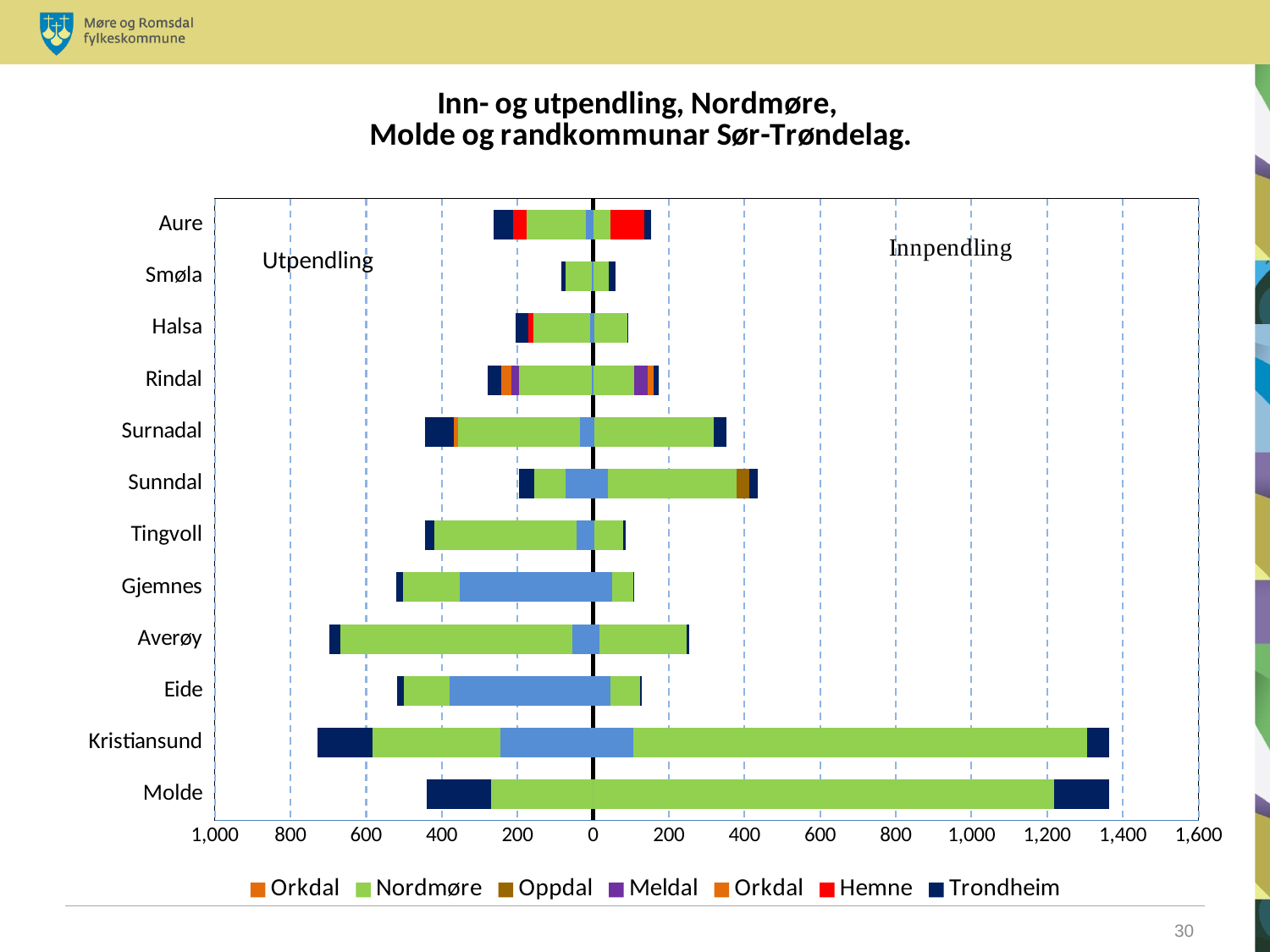
Is the Innpendling (right-side) bar for Molde greater or less than 1,000? greater How many series entries does the chart legend list? 7 How many municipalities (categories) are listed on the vertical axis of the chart? 12 Which side of the chart is labelled 'Innpendling', the left or the right? right Is the Utpendling (left-side) bar for Averøy greater or less than 600? greater Is the Innpendling (right-side) bar for Kristiansund greater or less than 1,200? greater Which has the longer Innpendling (right-side) bar, Surnadal or Tingvoll? Surnadal Which municipality has the shortest Innpendling (right-side) bar? Smøla What kind of chart is shown on the slide? bar chart What is the title of the chart? Inn- og utpendling, Nordmøre, Molde og randkommunar Sør-Trøndelag.